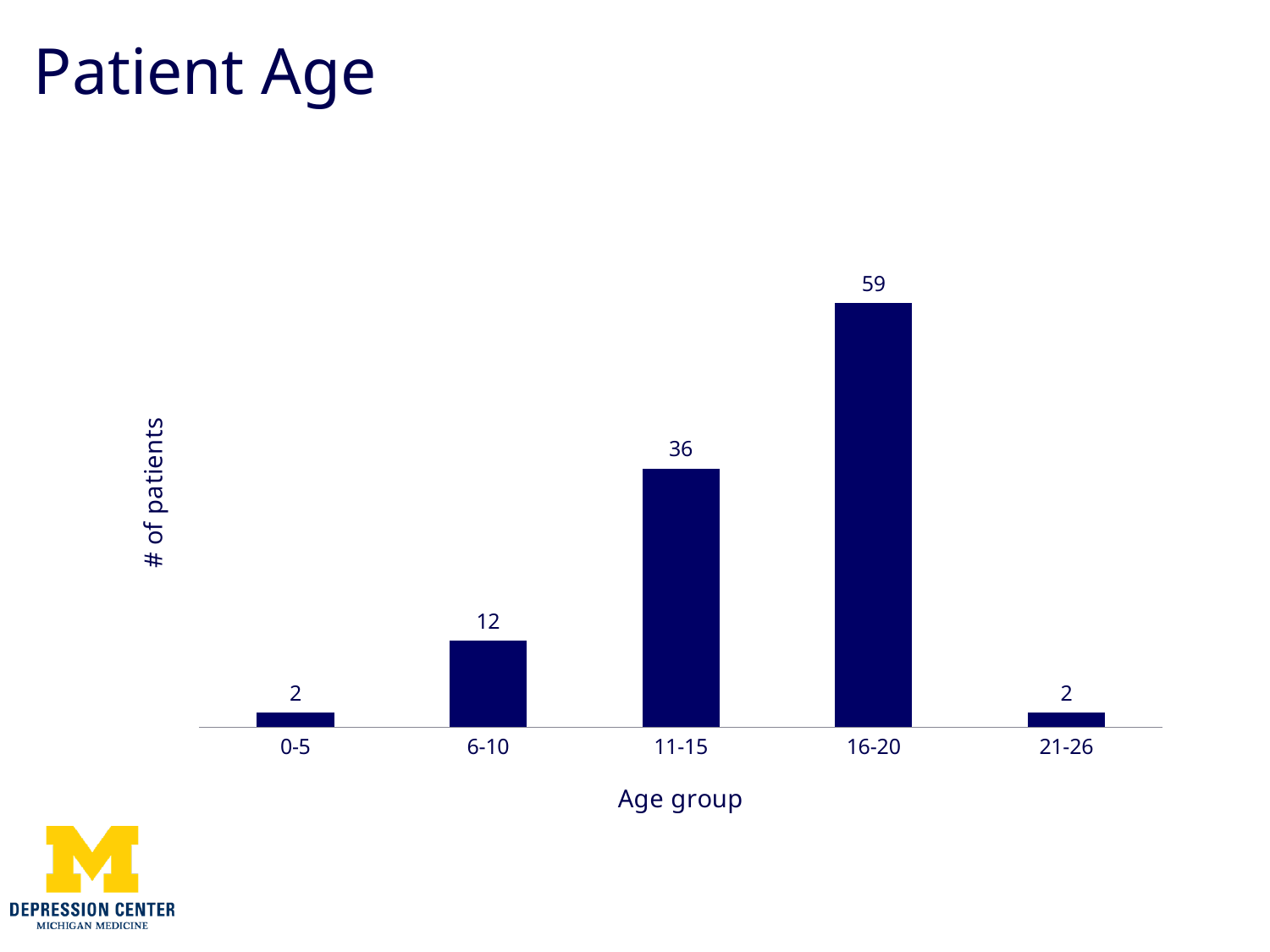
Which age group has more patients, 6-10 or 11-15? 11-15 How many patients are in the 16-20 age group? 59 How many patients are in the 6-10 age group? 12 What is the difference in number of patients between the 11-15 and 6-10 age groups? 24 What kind of chart is shown on the slide? Bar chart What is the label of the y axis? # of patients What is the total number of patients across all age groups? 111 How many patients are in the 11-15 age group? 36 What is the difference in number of patients between the 16-20 and 11-15 age groups? 23 How many age groups are shown on the x axis? 5 Which age group has the highest number of patients? 16-20 How many patients are in the 0-5 age group? 2